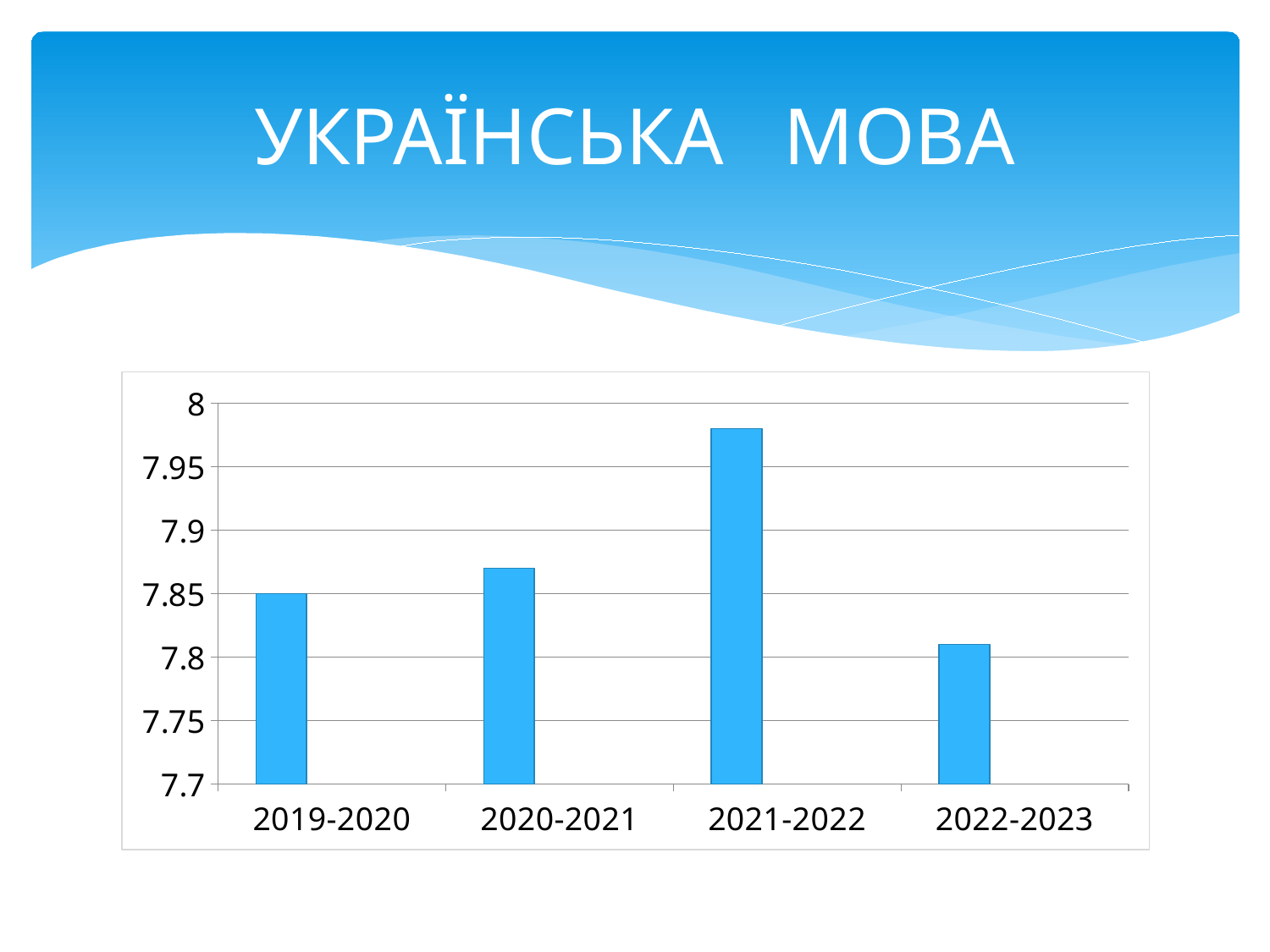
What is the title shown at the top of the slide above the chart? УКРАЇНСЬКА МОВА Is the value for 2021-2022 greater or less than 8? less Is the value for 2020-2021 greater or less than 7.85? greater What kind of chart is shown on the slide? bar chart Which is larger, the value for 2021-2022 or the value for 2019-2020? 2021-2022 How many categories (school years) are shown on the x axis of the chart? 4 Does the value rise or fall from 2021-2022 to 2022-2023? fall Which school year has the lowest bar in the chart? 2022-2023 Is the value for 2021-2022 greater or less than 7.95? greater Which school year has the highest bar in the chart? 2021-2022 What is the value for 2019-2020 in the chart? 7.85